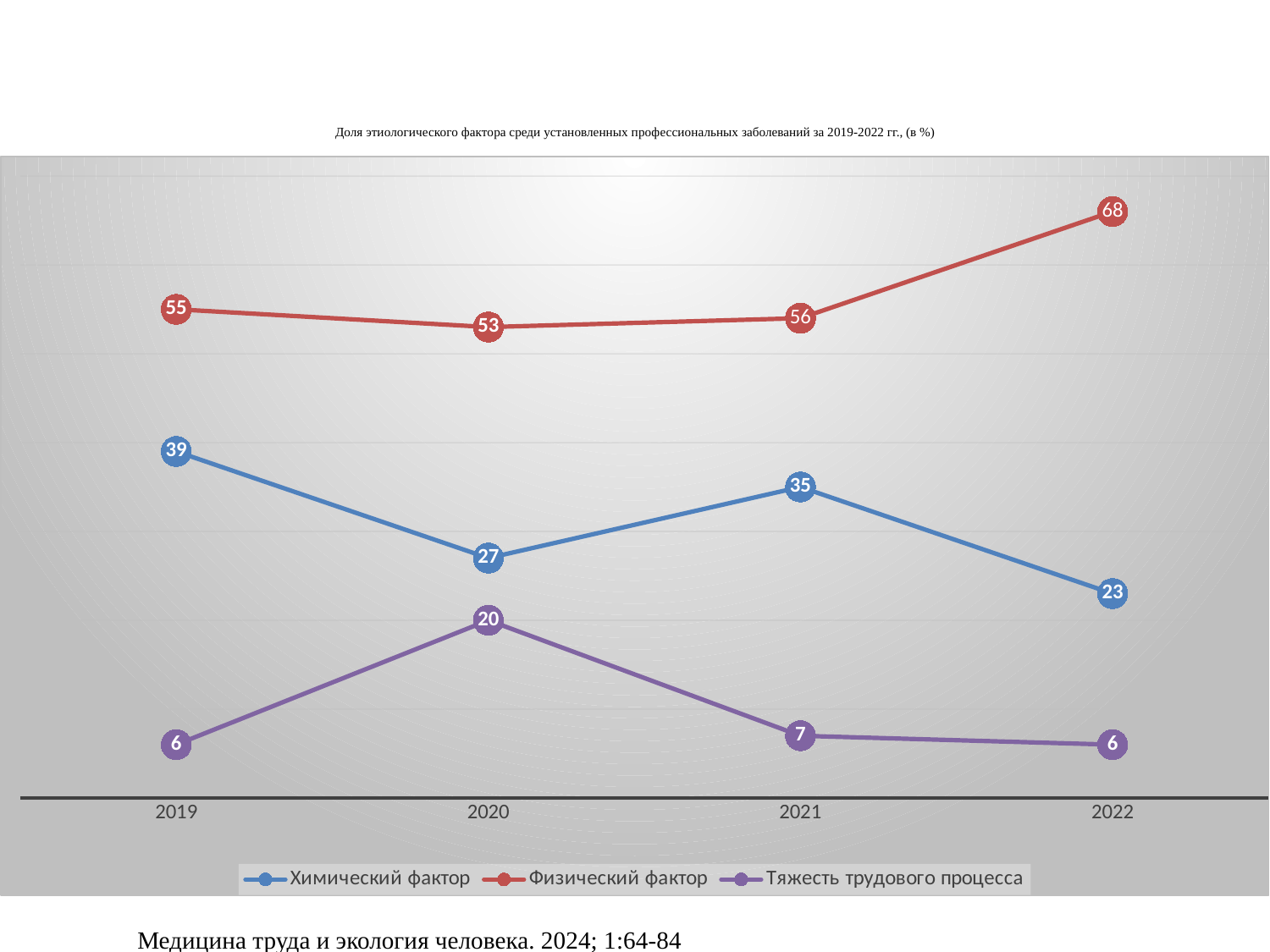
How many series does the legend list? 3 In which year is Химический фактор lowest? 2022 How many years are shown on the x axis? 4 What is the value for Тяжесть трудового процесса in 2021? 7 In which year is Физический фактор highest? 2022 Which colour is used for the Тяжесть трудового процесса series? purple What kind of chart is this? line chart Which is larger in 2020: Химический фактор or Тяжесть трудового процесса? Химический фактор What is the value for Физический фактор in 2022? 68 What is the difference between Физический фактор and Химический фактор in 2019? 16 What is the value for Химический фактор in 2020? 27 Does Физический фактор rise or fall from 2021 to 2022? rise